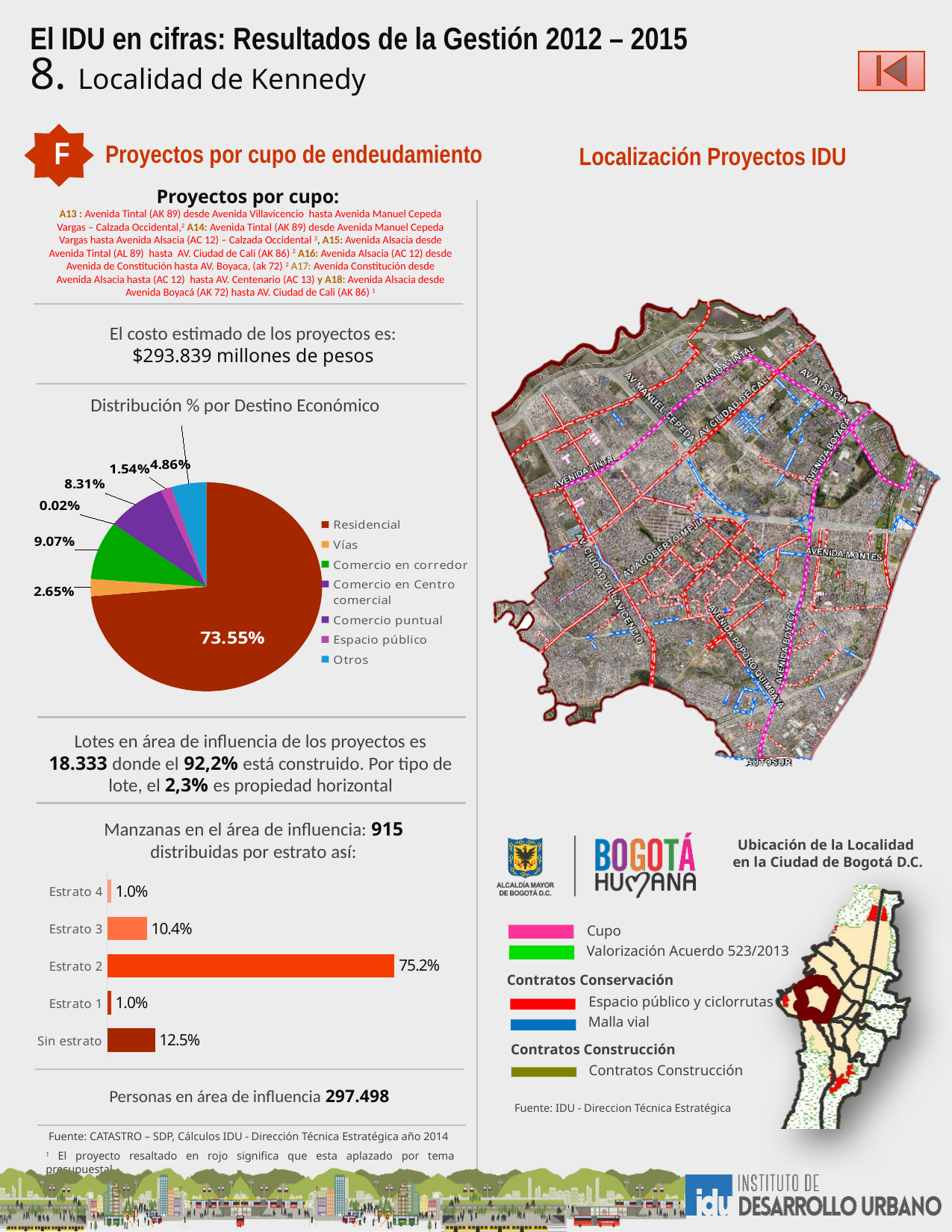
In the pie chart 'Distribución % por Destino Económico', what share does Residencial have? 73.55% In the bar chart 'Manzanas en el área de influencia: 915 distribuidas por estrato así', what is the value for Estrato 2? 75.2% What kind of chart is 'Distribución % por Destino Económico'? Pie chart In the bar chart 'Manzanas en el área de influencia: 915 distribuidas por estrato así', what is the value for Sin estrato? 12.5% In the pie chart 'Distribución % por Destino Económico', what is the difference between the Residencial share and the Comercio en corredor share? 64.48% In the pie chart 'Distribución % por Destino Económico', what is the share for Comercio en corredor? 9.07% In the pie chart 'Distribución % por Destino Económico', which is larger, Comercio puntual or Otros? Comercio puntual In the pie chart 'Distribución % por Destino Económico', how many entries does the legend list? 7 In the bar chart 'Manzanas en el área de influencia: 915 distribuidas por estrato así', how many categories are shown? 5 In the pie chart 'Distribución % por Destino Económico', which category has the largest share? Residencial What kind of chart is 'Manzanas en el área de influencia: 915 distribuidas por estrato así'? Bar chart In the bar chart 'Manzanas en el área de influencia: 915 distribuidas por estrato así', what is the difference between Sin estrato and Estrato 3? 2.1%